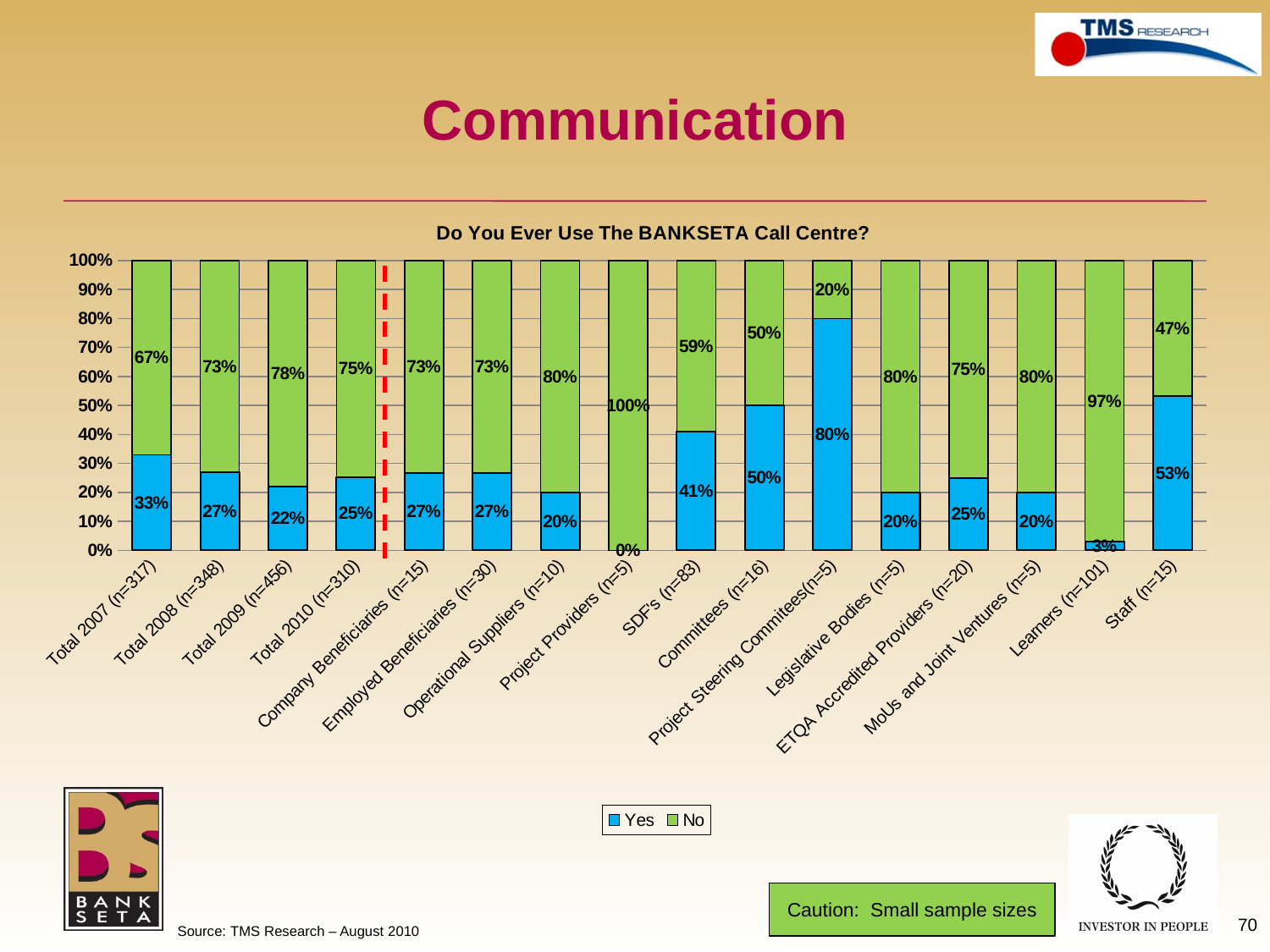
Which series is shown in green in the legend? No Which category has the lowest Yes percentage? Project Providers (n=5) What is the No value for Learners (n=101)? 97% Which category has the highest Yes percentage? Project Steering Committees (n=5) How many categories are shown on the x axis? 16 How many series does the legend list? 2 What kind of chart is shown? Stacked bar chart What percentage of Total 2007 (n=317) respondents answered Yes to using the BANKSETA Call Centre? 33% Is the Yes value for Learners (n=101) greater or less than 10%? less What is the difference between the Yes values for Total 2007 (n=317) and Total 2010 (n=310)? 8% Which is larger: the Yes value for SDF's (n=83) or the Yes value for Committees (n=16)? Committees (n=16) What is the Yes value for Staff (n=15)? 53%